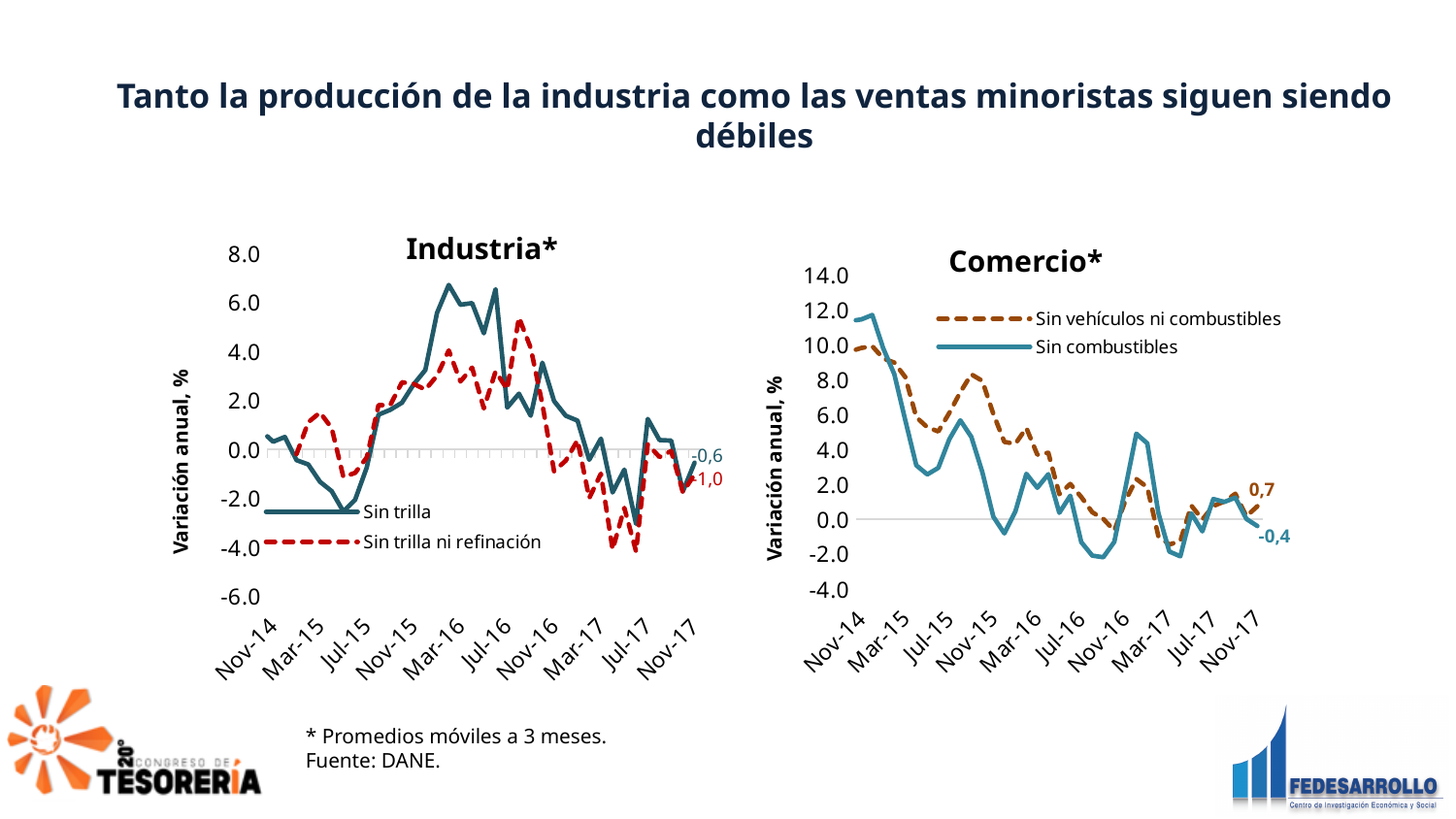
In the Comercio* chart, what is the final labelled value for the Sin vehículos ni combustibles series? 0,7 In the Comercio* chart, is the value of the Sin combustibles series at Nov-14 greater or less than 10.0? greater In the Comercio* chart, what is the difference between the final labelled values of Sin vehículos ni combustibles (0,7) and Sin combustibles (-0,4)? 1,1 In the Comercio* chart, what is the final labelled value for the Sin combustibles series? -0,4 In the Industria* chart, what is the final labelled value for the Sin trilla series? -0,6 How many series does the legend of the Industria* chart list? 2 What kind of chart is the Industria* chart? line chart What is the label on the vertical axis of the Comercio* chart? Variación anual, % In the Industria* chart, what is the final labelled value for the Sin trilla ni refinación series? -1,0 In the Industria* chart, what is the difference between the final labelled values of Sin trilla (-0,6) and Sin trilla ni refinación (-1,0)? 0,4 In the Industria* chart, which series has the higher final labelled value, Sin trilla or Sin trilla ni refinación? Sin trilla How many series does the legend of the Comercio* chart list? 2